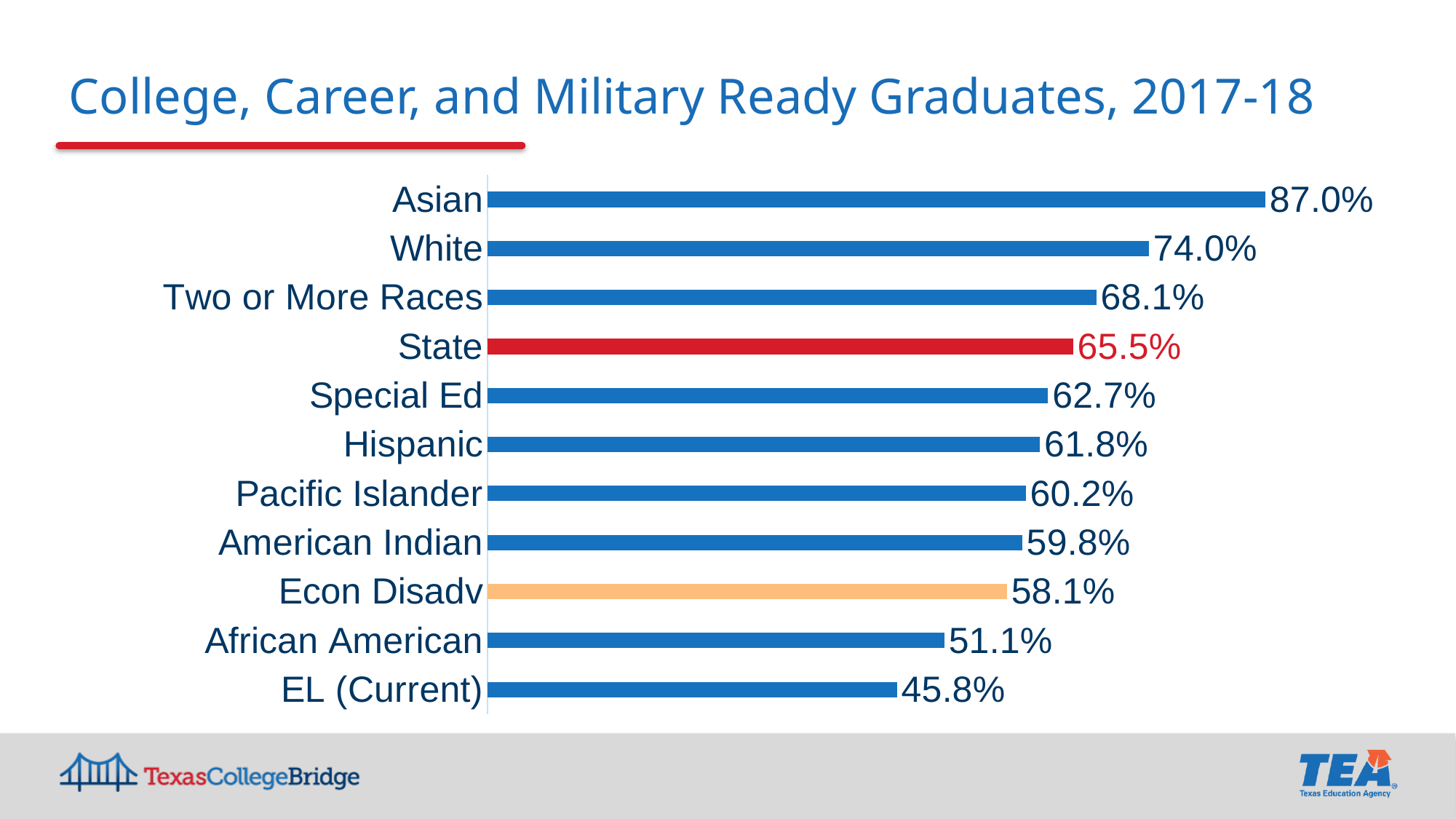
Which category has the highest value? Asian What is the difference between the values for White and African American? 22.9% What is the value for Econ Disadv? 58.1% How many categories are shown in the chart? 11 What is the value for State? 65.5% What is the value for Asian? 87.0% What is the value for EL (Current)? 45.8% Which is larger, the value for Hispanic or the value for Pacific Islander? Hispanic Which category has the lowest value? EL (Current) What kind of chart is shown on the slide? Bar chart What is the title of the slide? College, Career, and Military Ready Graduates, 2017-18 Which category's bar is coloured red? State